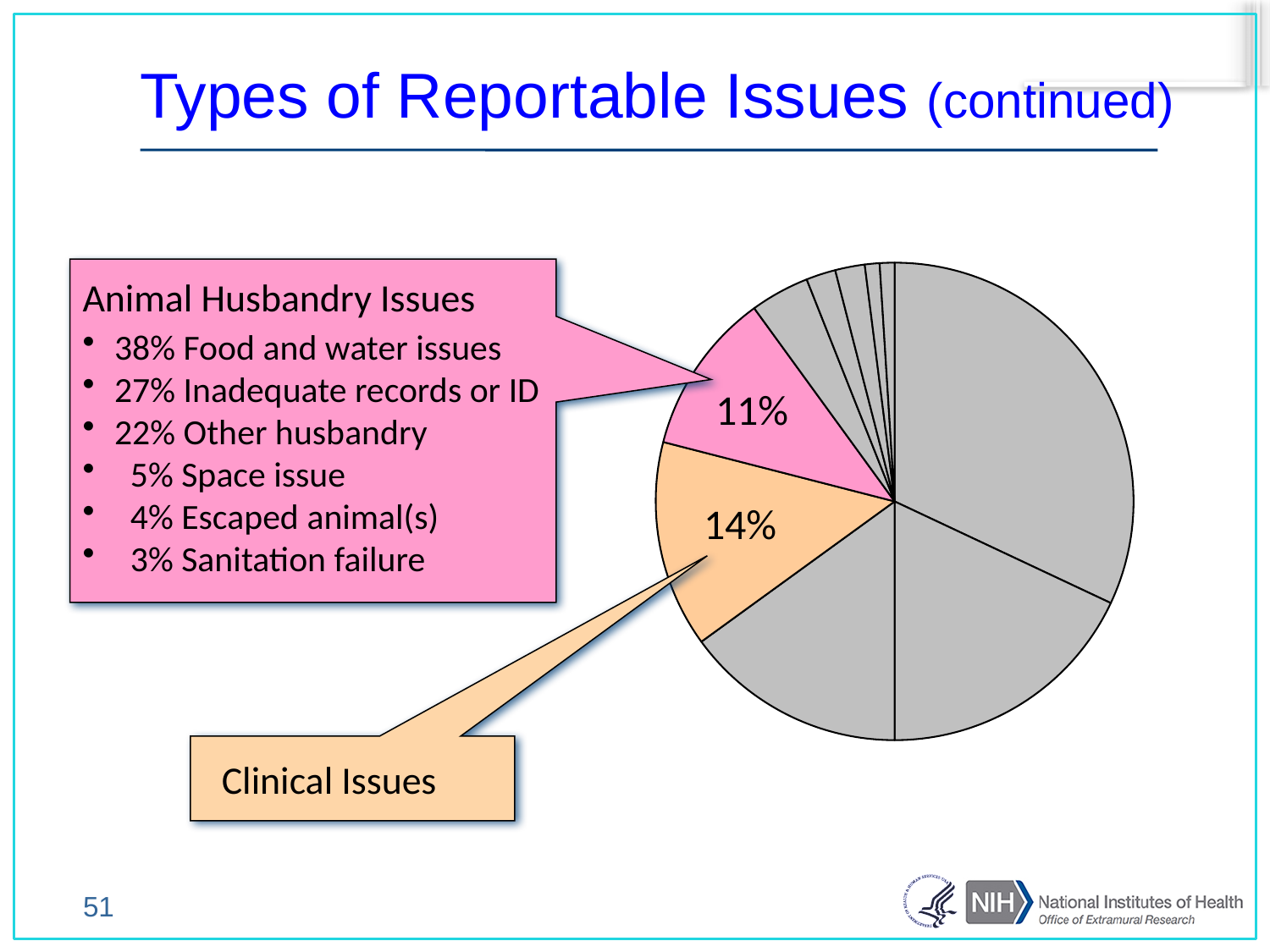
What is the combined share of the Clinical Issues and Animal Husbandry Issues slices? 25% What share of the pie is labelled for Clinical Issues? 14% By how many percentage points does the Clinical Issues slice exceed the Animal Husbandry Issues slice? 3 percentage points Is the share for Clinical Issues greater or less than 10%? greater What kind of chart is shown on the slide? Pie chart What share of the pie is labelled for Animal Husbandry Issues? 11% What is the title of the slide containing the pie chart? Types of Reportable Issues (continued) What colour is the Animal Husbandry Issues slice of the pie? Pink Which is larger, the Clinical Issues slice or the Animal Husbandry Issues slice? Clinical Issues